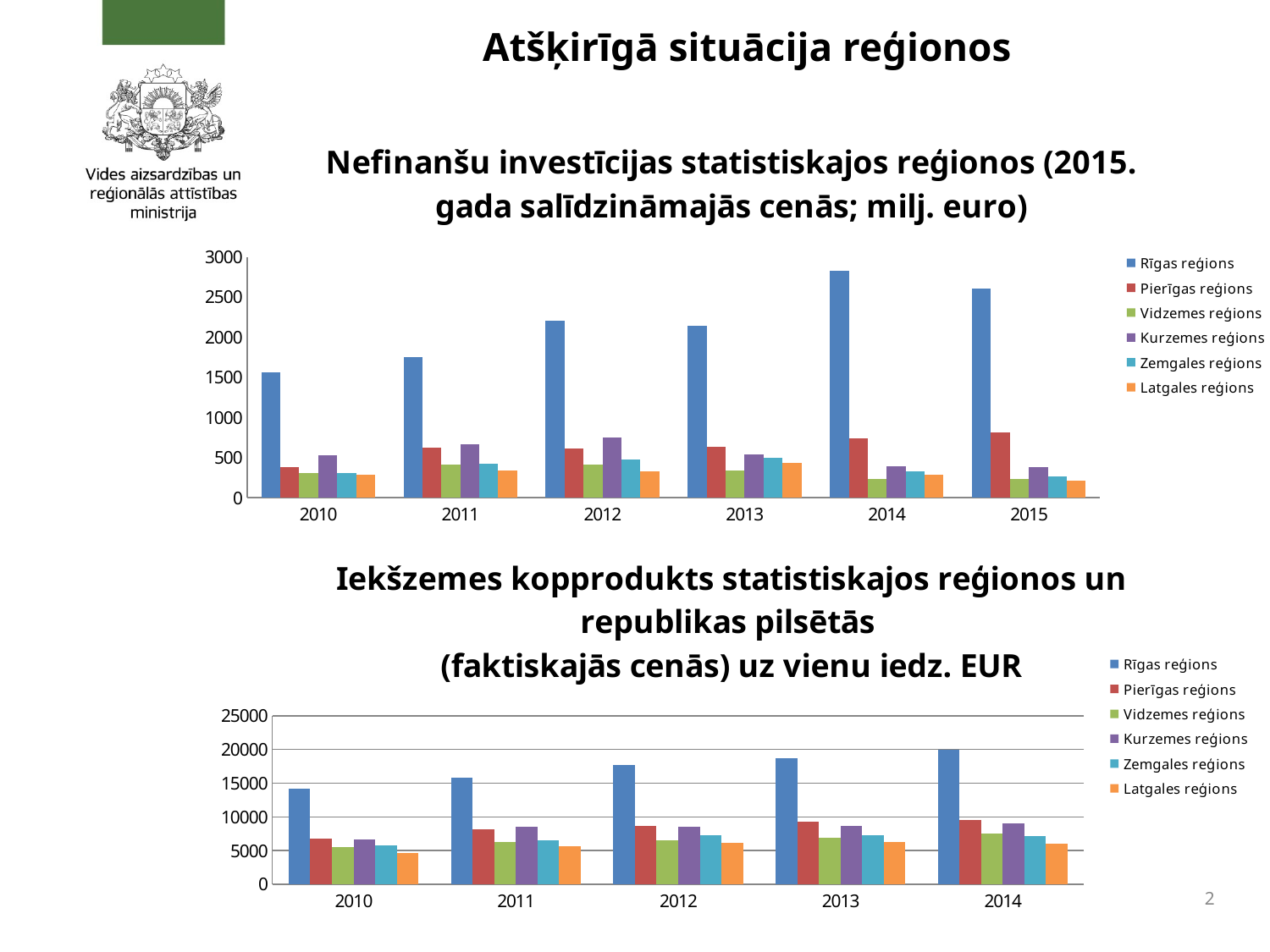
In the bottom chart (Iekšzemes kopprodukts), is the value for Rīgas reģions in 2010 greater or less than 15000? less In the top chart (Nefinanšu investīcijas), which is larger in 2012: Kurzemes reģions or Pierīgas reģions? Kurzemes reģions In the bottom chart (Iekšzemes kopprodukts), is the value for Rīgas reģions in 2014 greater or less than 15000? greater In the top chart (Nefinanšu investīcijas), is the value for Rīgas reģions in 2014 greater or less than 2500? greater In the top chart (Nefinanšu investīcijas), how many years are shown on the x axis? 6 In the top chart (Nefinanšu investīcijas), which region has the highest value in 2014? Rīgas reģions In the top chart (Nefinanšu investīcijas), in which year does Rīgas reģions reach its highest value? 2014 What kind of chart is the bottom chart (Iekšzemes kopprodukts)? bar chart In the bottom chart (Iekšzemes kopprodukts), which region has the lowest value in 2010? Latgales reģions In the top chart (Nefinanšu investīcijas), how many series does the legend list? 6 In the bottom chart (Iekšzemes kopprodukts), do the values for Rīgas reģions rise or fall from 2010 to 2014? rise